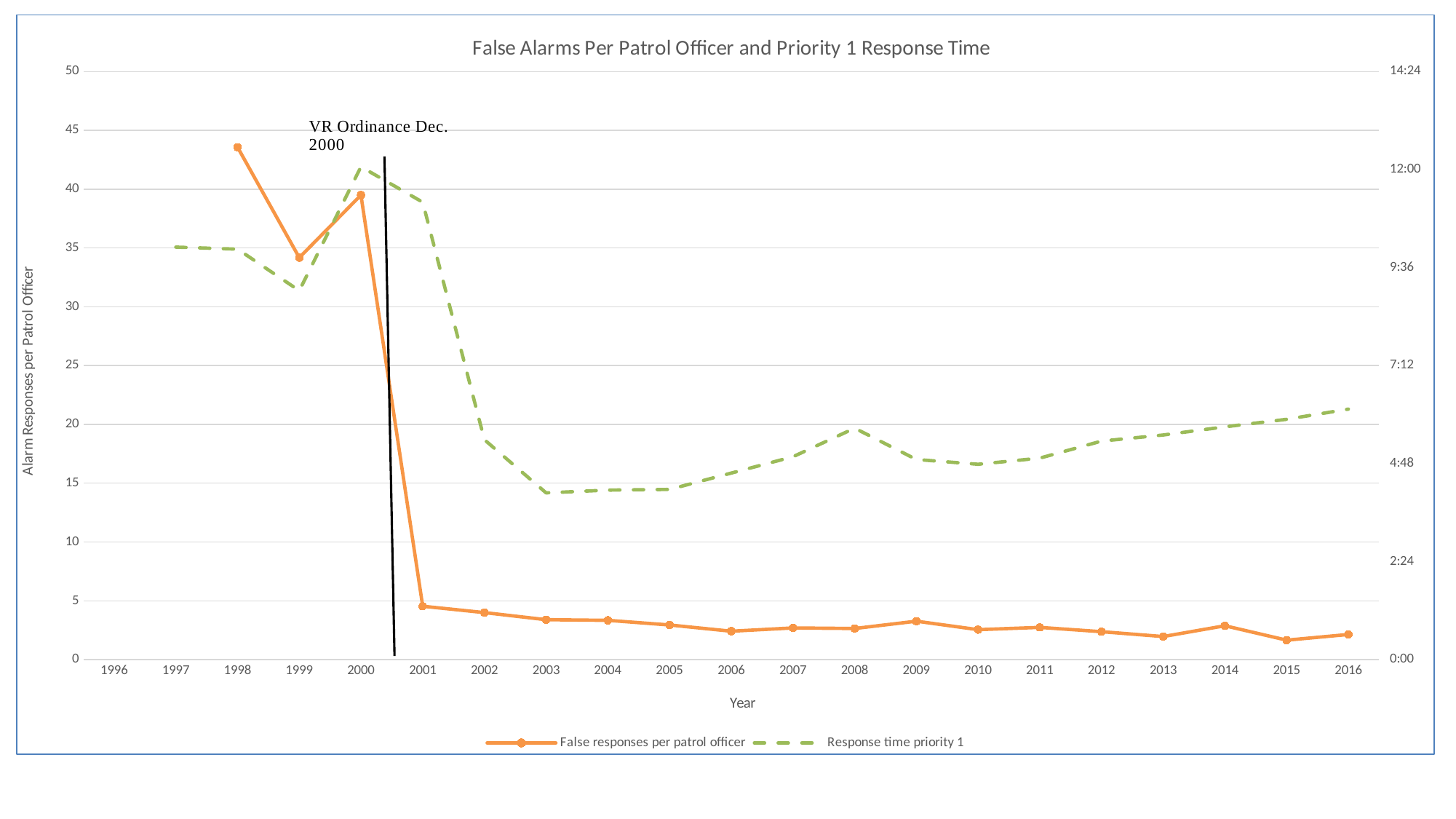
Which year has the larger value for False responses per patrol officer, 1999 or 2000? 2000 How many years are labelled on the x axis? 21 Is the value for False responses per patrol officer in 1998 greater or less than 40? greater What kind of chart is shown on the slide? line chart Is the value for False responses per patrol officer in 2001 greater or less than 5? less Is the value for Response time priority 1 in 2016 greater or less than 4:48? greater In which year is the value for Response time priority 1 highest? 2000 What event does the annotation next to the vertical black line mark? VR Ordinance Dec. 2000 What is the title of the chart? False Alarms Per Patrol Officer and Priority 1 Response Time In which year is the value for False responses per patrol officer highest? 1998 How many series does the legend list? 2